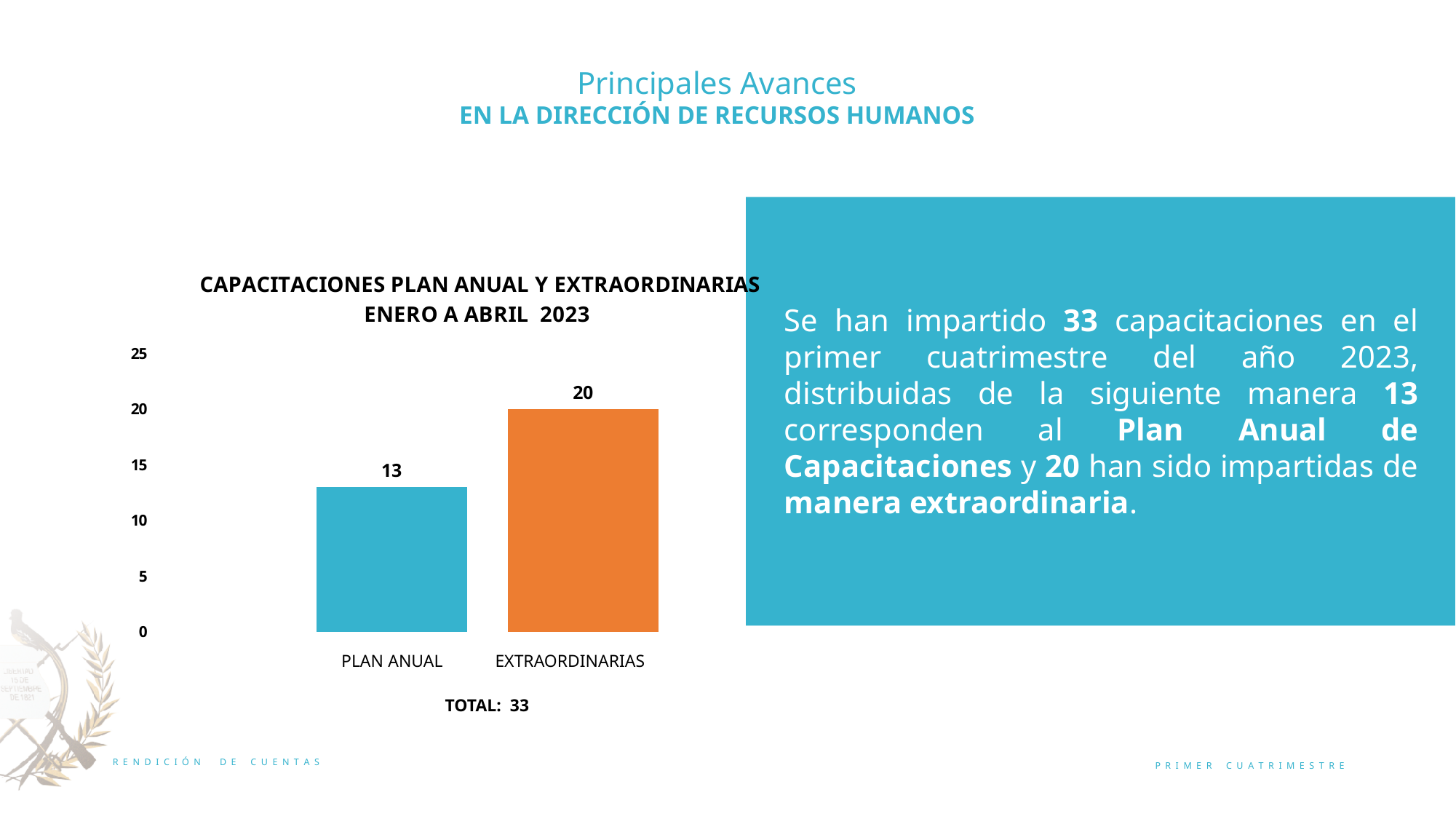
How many categories are shown in the chart? 2 What is the value for PLAN ANUAL? 13 What is the value for EXTRAORDINARIAS? 20 What is the difference between the values for EXTRAORDINARIAS and PLAN ANUAL? 7 What is the title of the chart? CAPACITACIONES PLAN ANUAL Y EXTRAORDINARIAS ENERO A ABRIL 2023 Which category has the lowest value? PLAN ANUAL What is the total of the two bars in the chart? 33 What kind of chart is shown on the slide? bar chart What colour is the bar for EXTRAORDINARIAS? orange Which category has the highest value? EXTRAORDINARIAS Is the value for PLAN ANUAL greater or less than 15? less Which is larger, the value for PLAN ANUAL or the value for EXTRAORDINARIAS? EXTRAORDINARIAS